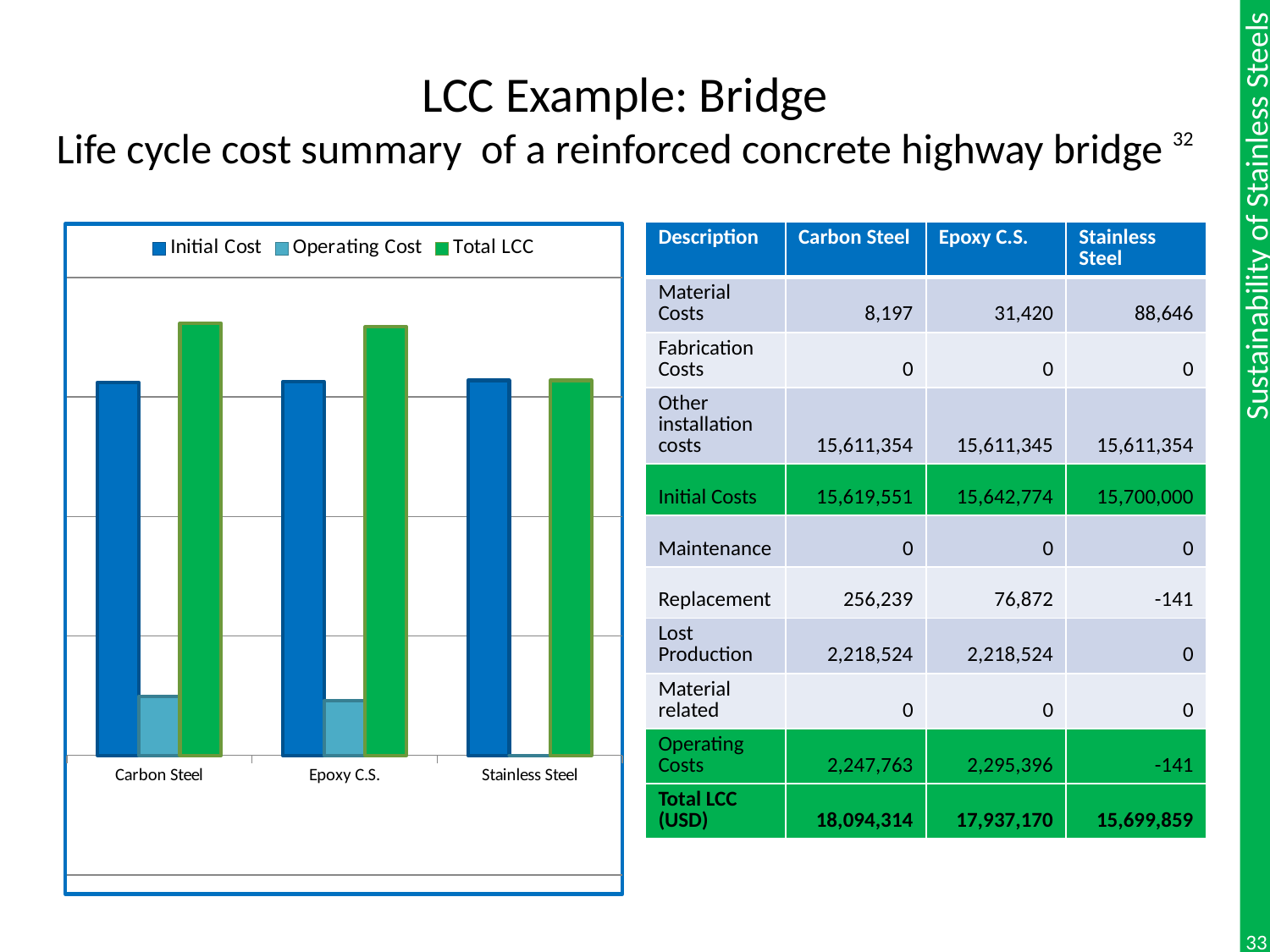
Which category has the lowest Total LCC bar in the chart? Stainless Steel Do the Total LCC bars rise or fall from Carbon Steel to Stainless Steel along the x axis? fall What kind of chart is shown on the slide? bar chart Which category has the lowest Operating Cost bar in the chart? Stainless Steel In the chart, is the Operating Cost bar larger for Epoxy C.S. or for Stainless Steel? Epoxy C.S. What colour are the Total LCC bars in the chart? green In the chart, is the Total LCC bar larger for Carbon Steel or for Stainless Steel? Carbon Steel For Epoxy C.S. in the chart, which is larger: the Operating Cost bar or the Initial Cost bar? Initial Cost How many series does the chart's legend list? 3 Which series are listed in the chart's legend? Initial Cost, Operating Cost, Total LCC How many categories are shown on the x axis of the chart? 3